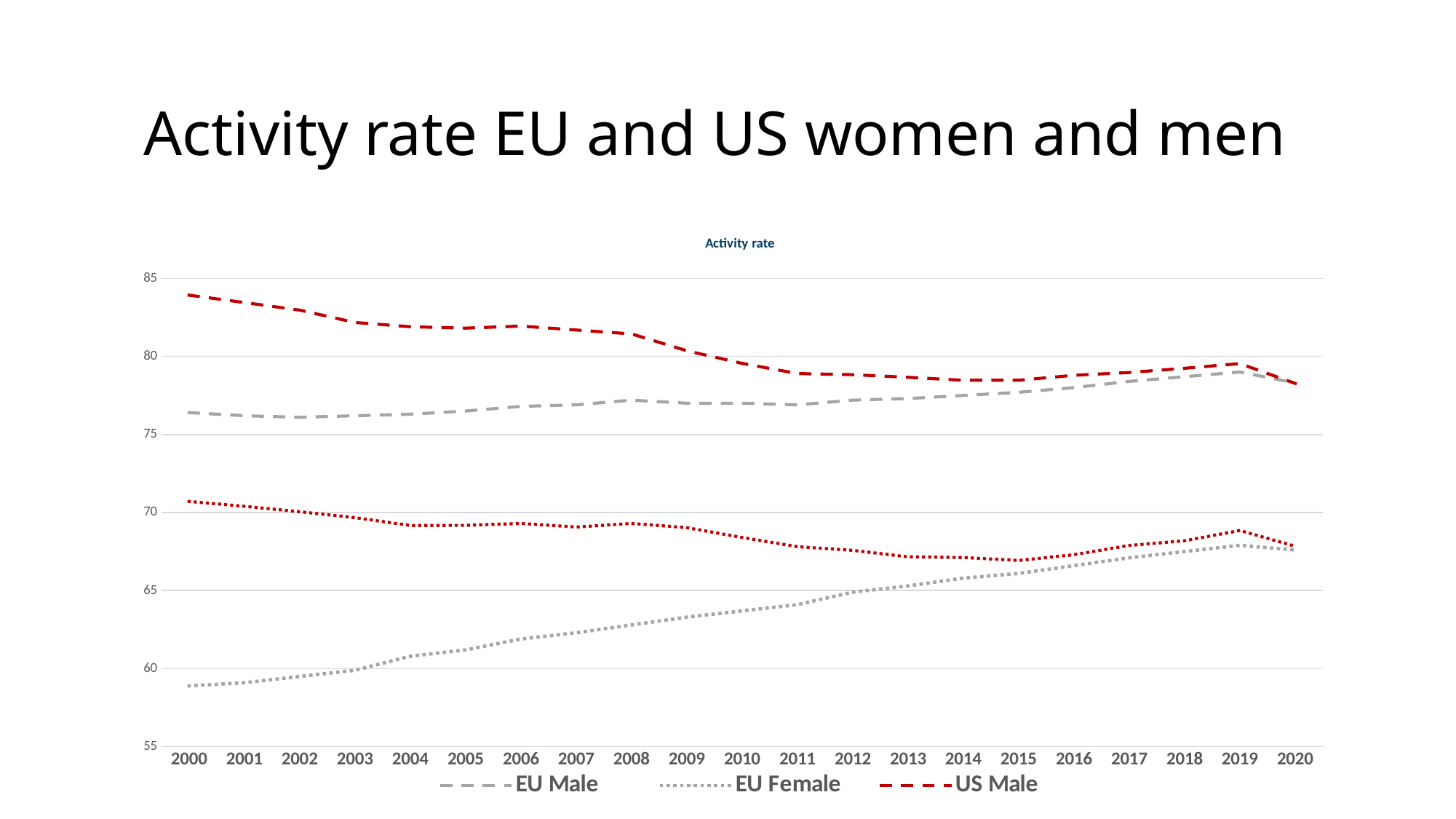
Is the value for EU Female in 2000 greater or less than 60? less What is the title of the chart? Activity rate How many series does the legend list? 3 Does the EU Female line rise or fall from 2000 to 2020? Rises How many years are shown along the x axis? 21 Is the value for US Male in 2000 greater or less than 80? greater What kind of chart is shown on the slide? Line chart Is the value for EU Female in 2020 greater or less than 65? greater Does the US Male line rise or fall overall from 2000 to 2020? Falls Which is larger in 2000, US Male or EU Male? US Male Which of the series listed in the legend has the lowest value in 2000? EU Female